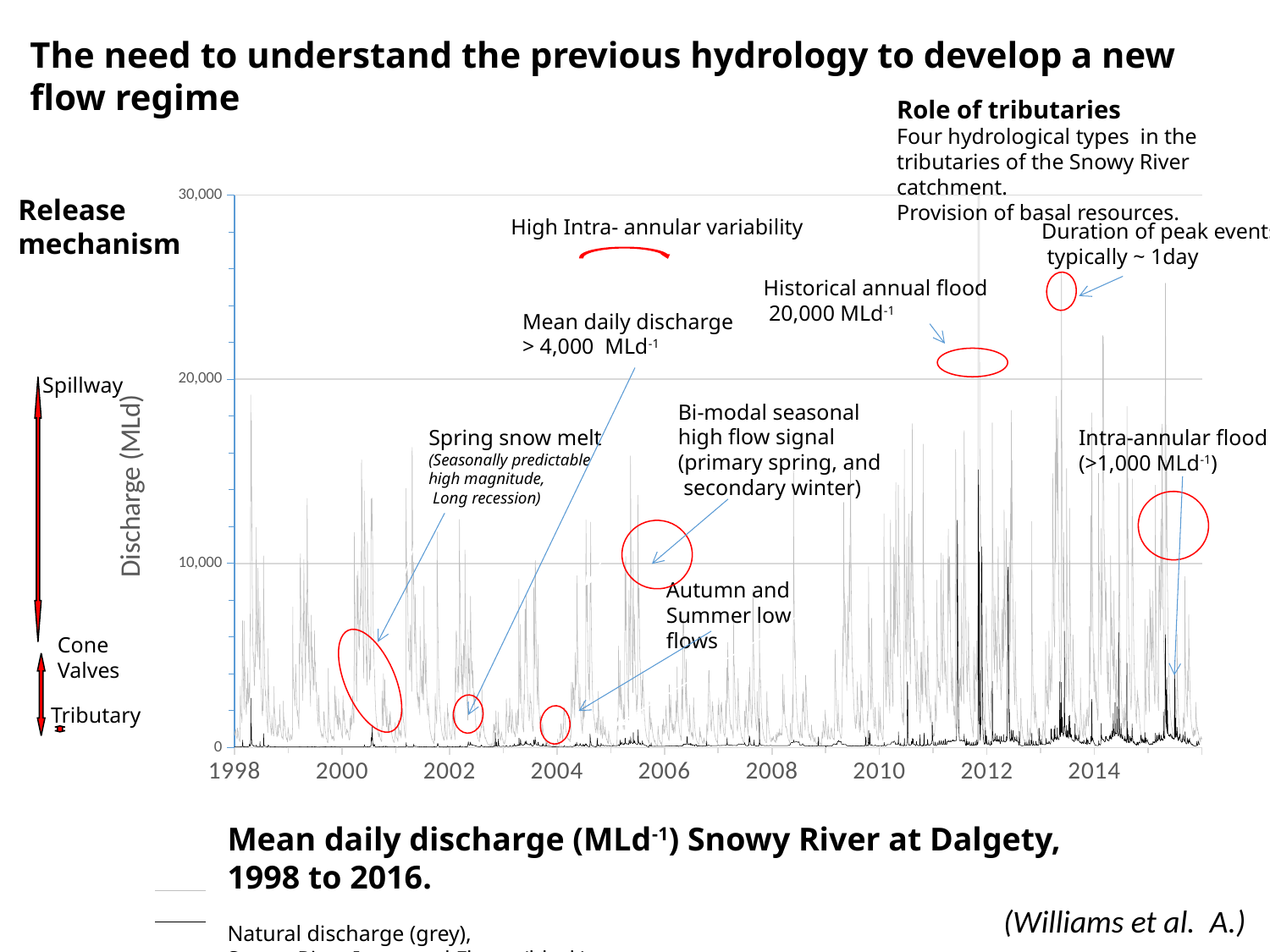
Is the peak of the black discharge series around 2015 greater or less than 10,000? less What is the highest value shown on the y axis of the chart? 30,000 Is the peak natural (grey) discharge around 2007 greater or less than 20,000? less Is the peak natural (grey) discharge around 2000 greater or less than 10,000? greater What is the last year labelled on the x axis of the chart? 2014 What value does the chart annotation give for the historical annual flood? 20,000 MLd-1 What kind of chart is shown on the slide? line chart How many year labels are shown on the x axis of the chart? 9 What is the first year labelled on the x axis of the chart? 1998 Which colour represents natural discharge in the chart? grey What is the title of the chart? Mean daily discharge (MLd-1) Snowy River at Dalgety, 1998 to 2016.